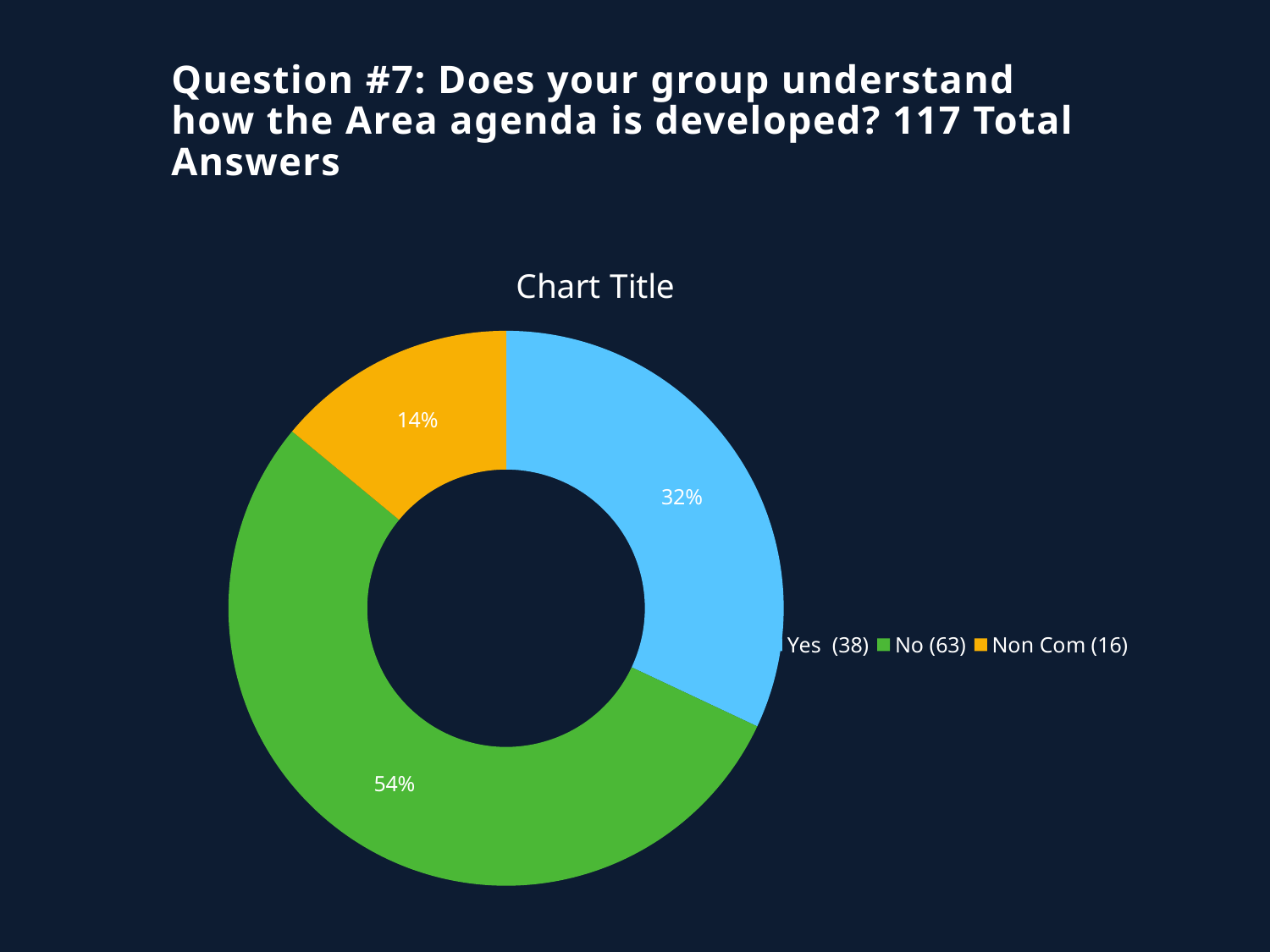
Which category has the largest share of the chart? No (63) Which slice is larger, "Yes (38)" or "Non Com (16)"? Yes (38) What colour is the "No (63)" slice? Green What is the combined percentage of the "Yes (38)" and "Non Com (16)" slices? 46% What percentage of the doughnut chart does the "No (63)" slice represent? 54% How many categories are shown in the chart? 3 Which category has the smallest share of the chart? Non Com (16) What kind of chart is shown on the slide? Doughnut chart What percentage is shown for the "Non Com (16)" slice? 14% What percentage is shown for the "Yes (38)" slice? 32% What is the difference in percentage points between the "No (63)" slice and the "Yes (38)" slice? 22 What is the title displayed above the chart? Chart Title